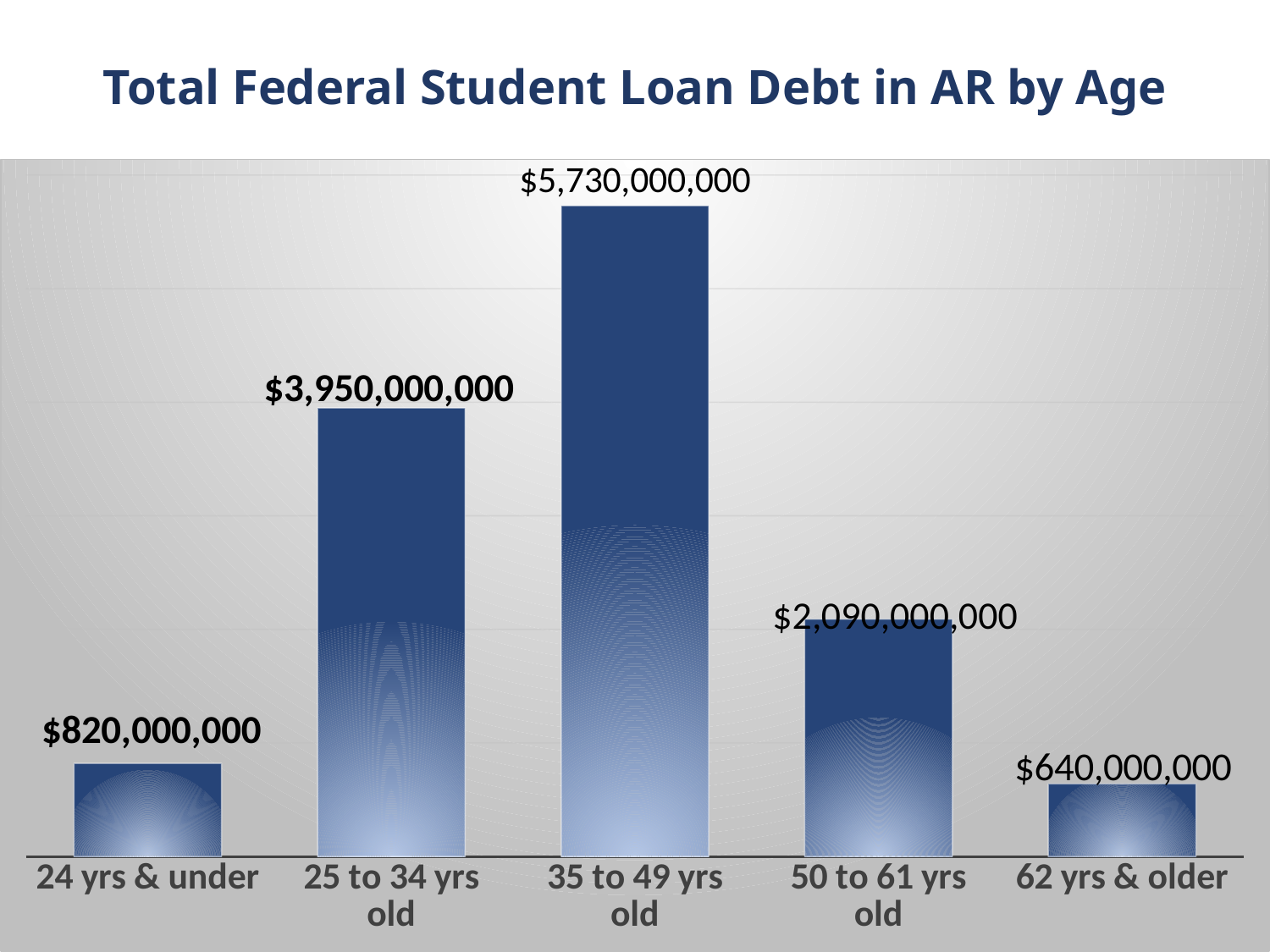
Which age group has the highest total federal student loan debt? 35 to 49 yrs old What is the total federal student loan debt for the 24 yrs & under group? $820,000,000 Which has more federal student loan debt: the 25 to 34 yrs old group or the 50 to 61 yrs old group? 25 to 34 yrs old What is the total federal student loan debt for the 50 to 61 yrs old group? $2,090,000,000 What is the difference in debt between the 35 to 49 yrs old group and the 25 to 34 yrs old group? $1,780,000,000 What is the total federal student loan debt for the 35 to 49 yrs old group? $5,730,000,000 What is the title of the chart? Total Federal Student Loan Debt in AR by Age What kind of chart is shown on the slide? Bar chart How many age groups are shown in the chart? 5 Which age group has the lowest total federal student loan debt? 62 yrs & older What is the difference in debt between the 24 yrs & under group and the 62 yrs & older group? $180,000,000 What is the total federal student loan debt for the 62 yrs & older group? $640,000,000